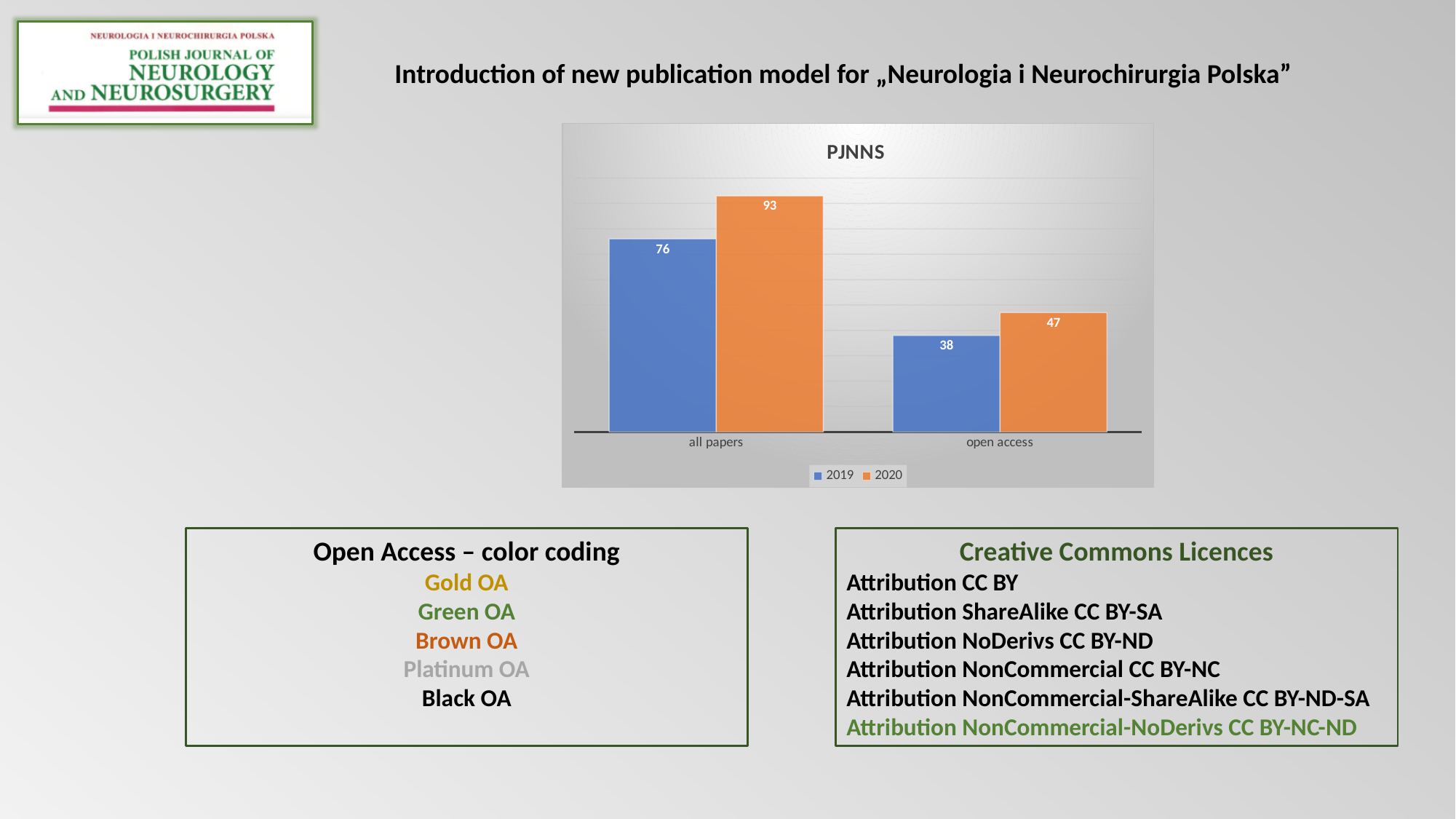
What is the value for all papers in 2019? 76 Which is larger: the 2019 value for all papers or the 2020 value for open access? 2019 value for all papers What is the difference between the 2020 and 2019 values for all papers? 17 What is the difference between the 2020 and 2019 values for open access? 9 How many categories are shown on the x axis? 2 How many series does the legend list? 2 What is the value for open access in 2019? 38 Which bar has the lowest value in the chart? open access, 2019 What is the value for all papers in 2020? 93 What type of chart is shown on the slide? bar chart What is the value for open access in 2020? 47 Which bar has the highest value in the chart? all papers, 2020